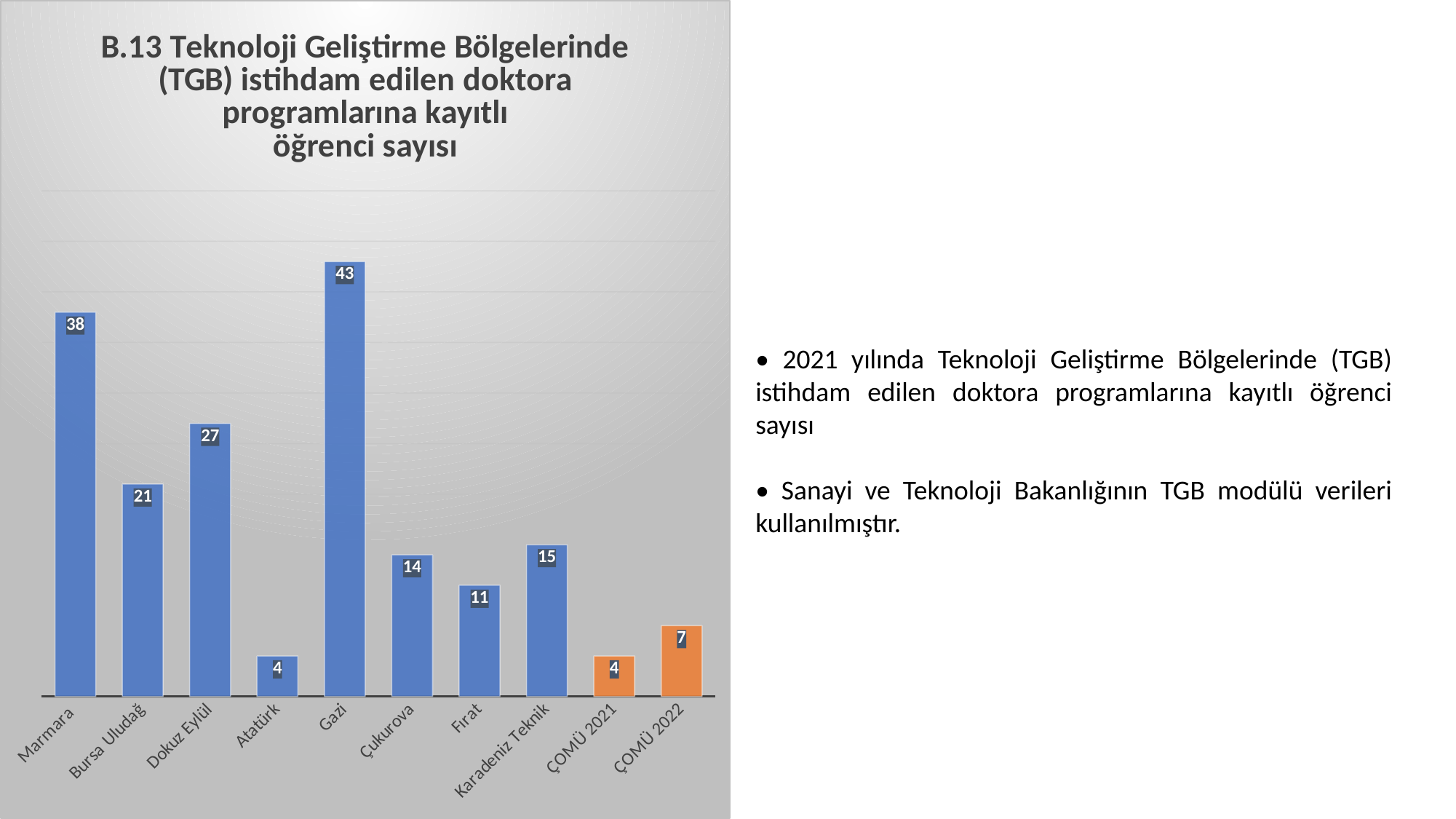
How many categories are shown on the x axis? 10 Which is larger, the value for Çukurova or the value for Fırat? Çukurova Which is larger, the value for Dokuz Eylül or the value for Bursa Uludağ? Dokuz Eylül What is the difference between the values for Gazi and Marmara? 5 What kind of chart is shown on the slide? Bar chart What is the difference between the values for ÇOMÜ 2022 and ÇOMÜ 2021? 3 What is the value for Marmara? 38 Which bars are coloured orange rather than blue? ÇOMÜ 2021 and ÇOMÜ 2022 Which category has the highest value? Gazi What is the value for ÇOMÜ 2022? 7 What is the value for Karadeniz Teknik? 15 What is the value for Gazi? 43